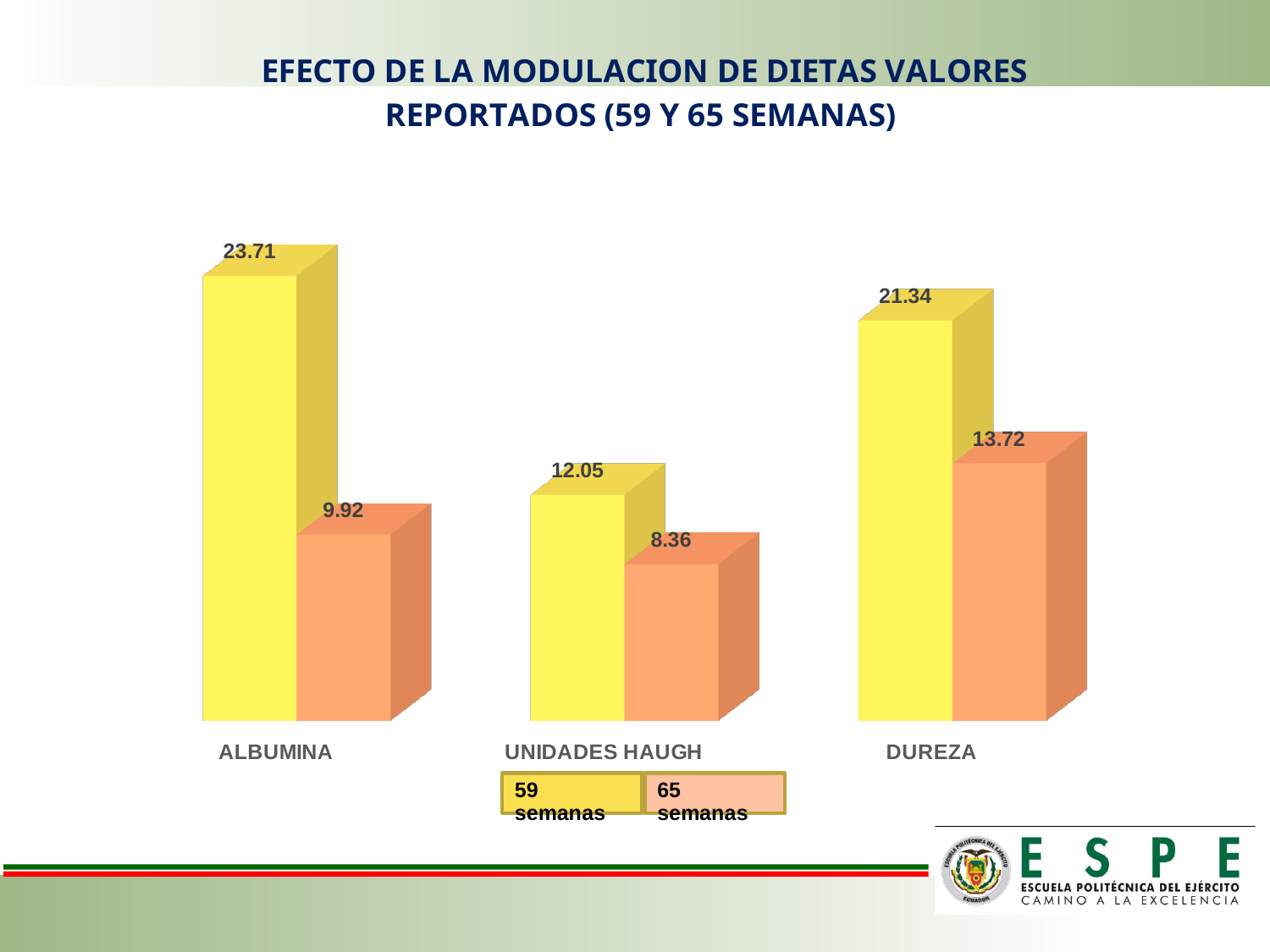
How many series does the legend list? 2 What is the value for ALBUMINA in the 59 semanas series? 23.71 Which category has the highest value in the 59 semanas series? ALBUMINA Which series is shown in yellow? 59 semanas What is the difference between the 59 semanas and 65 semanas values for DUREZA? 7.62 What is the value for UNIDADES HAUGH in the 59 semanas series? 12.05 What is the difference between the 59 semanas and 65 semanas values for ALBUMINA? 13.79 Which is larger: the 65 semanas value for ALBUMINA or the 65 semanas value for UNIDADES HAUGH? ALBUMINA How many categories are shown on the x axis? 3 Which category has the lowest value in the 65 semanas series? UNIDADES HAUGH What kind of chart is shown on the slide? Bar chart What is the value for DUREZA in the 65 semanas series? 13.72